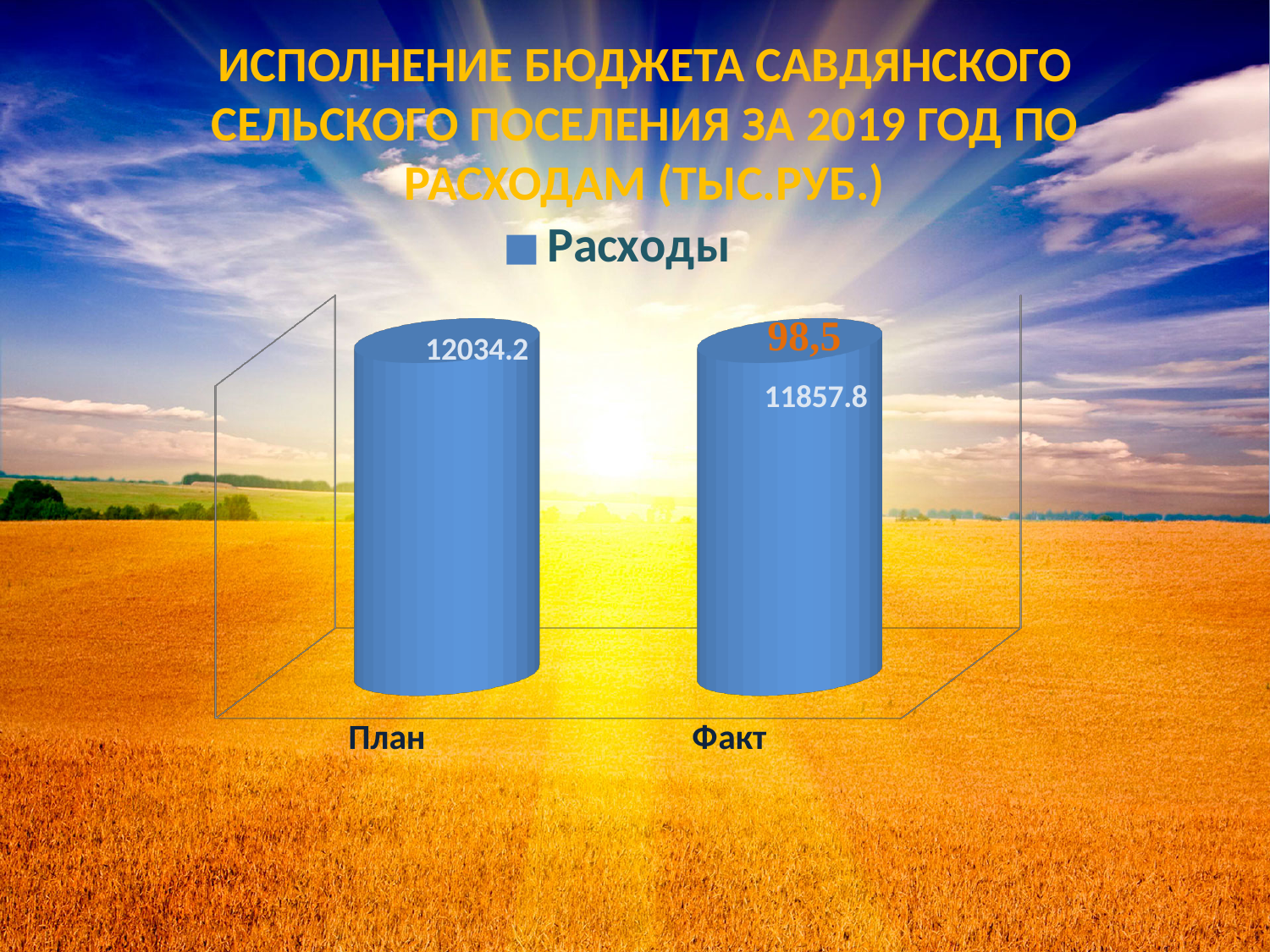
Which category has the higher value, План or Факт? План How many categories are shown in the chart? 2 What is the difference between the План value and the Факт value? 176.4 What orange number is printed above the Факт bar? 98,5 Which category has the highest value in the chart? План What is the value for План in the chart? 12034.2 What kind of chart is shown on the slide? Bar chart Do the values fall or rise from План to Факт? Fall How many series does the legend list? 1 Which category has the lowest value in the chart? Факт What is the value for Факт in the chart? 11857.8 What is the name of the series shown in the legend? Расходы